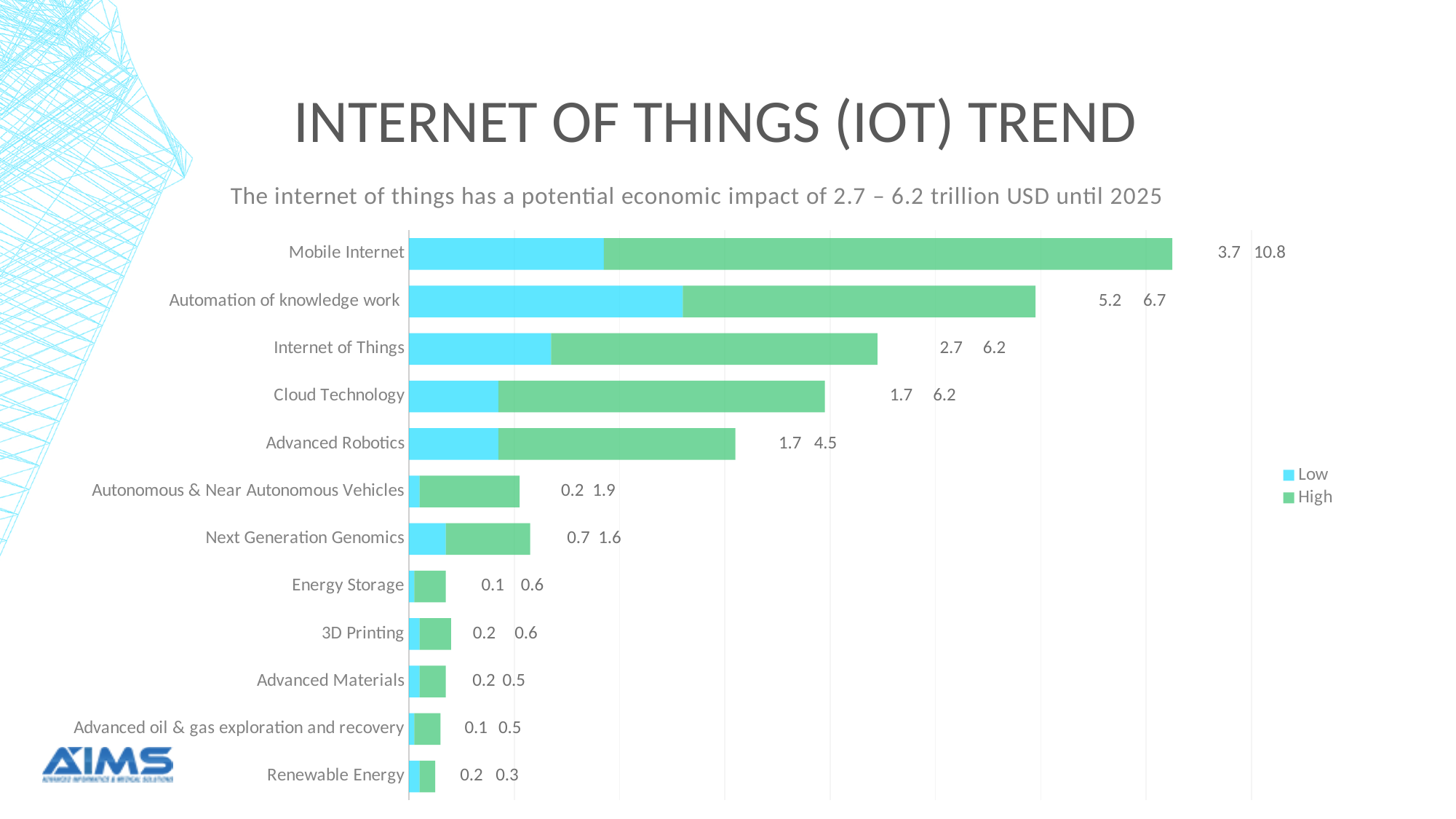
Which category has the lowest High value? Renewable Energy What is the Low value for Next Generation Genomics? 0.7 What is the total of the stacked bar for Mobile Internet (Low plus High)? 14.5 Which is larger, the Low value for Advanced Robotics or the Low value for Internet of Things? Internet of Things What kind of chart is shown on the slide? Stacked bar chart What is the High value for Mobile Internet? 10.8 How many series does the legend list? 2 Which category has the highest High value? Mobile Internet How many categories are shown in the chart? 12 What is the High value for Cloud Technology? 6.2 What is the difference between the High and Low values for Internet of Things? 3.5 What is the Low value for Automation of knowledge work? 5.2